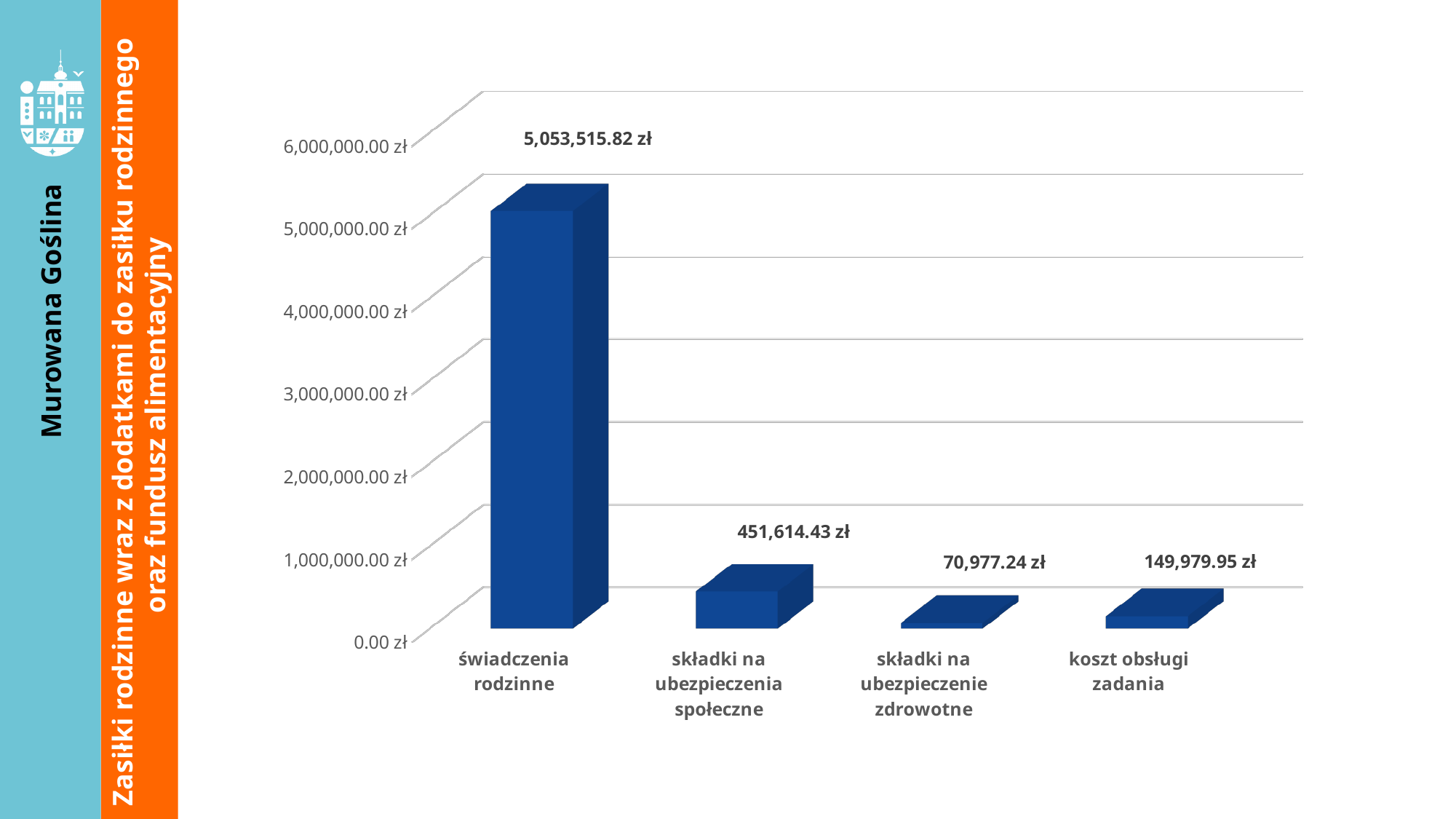
Which is larger: składki na ubezpieczenia społeczne or koszt obsługi zadania? składki na ubezpieczenia społeczne Which category has the lowest value? składki na ubezpieczenie zdrowotne Which category has the highest value? świadczenia rodzinne What is the difference between koszt obsługi zadania and składki na ubezpieczenie zdrowotne? 79,002.71 zł What is the value for koszt obsługi zadania? 149,979.95 zł What kind of chart is shown on the slide? bar chart What is the value for składki na ubezpieczenie zdrowotne? 70,977.24 zł How many categories are shown in the chart? 4 What is the value for składki na ubezpieczenia społeczne? 451,614.43 zł What is the value for świadczenia rodzinne? 5,053,515.82 zł What is the difference between świadczenia rodzinne and składki na ubezpieczenia społeczne? 4,601,901.39 zł Is the value for świadczenia rodzinne greater or less than 4,000,000.00 zł? greater